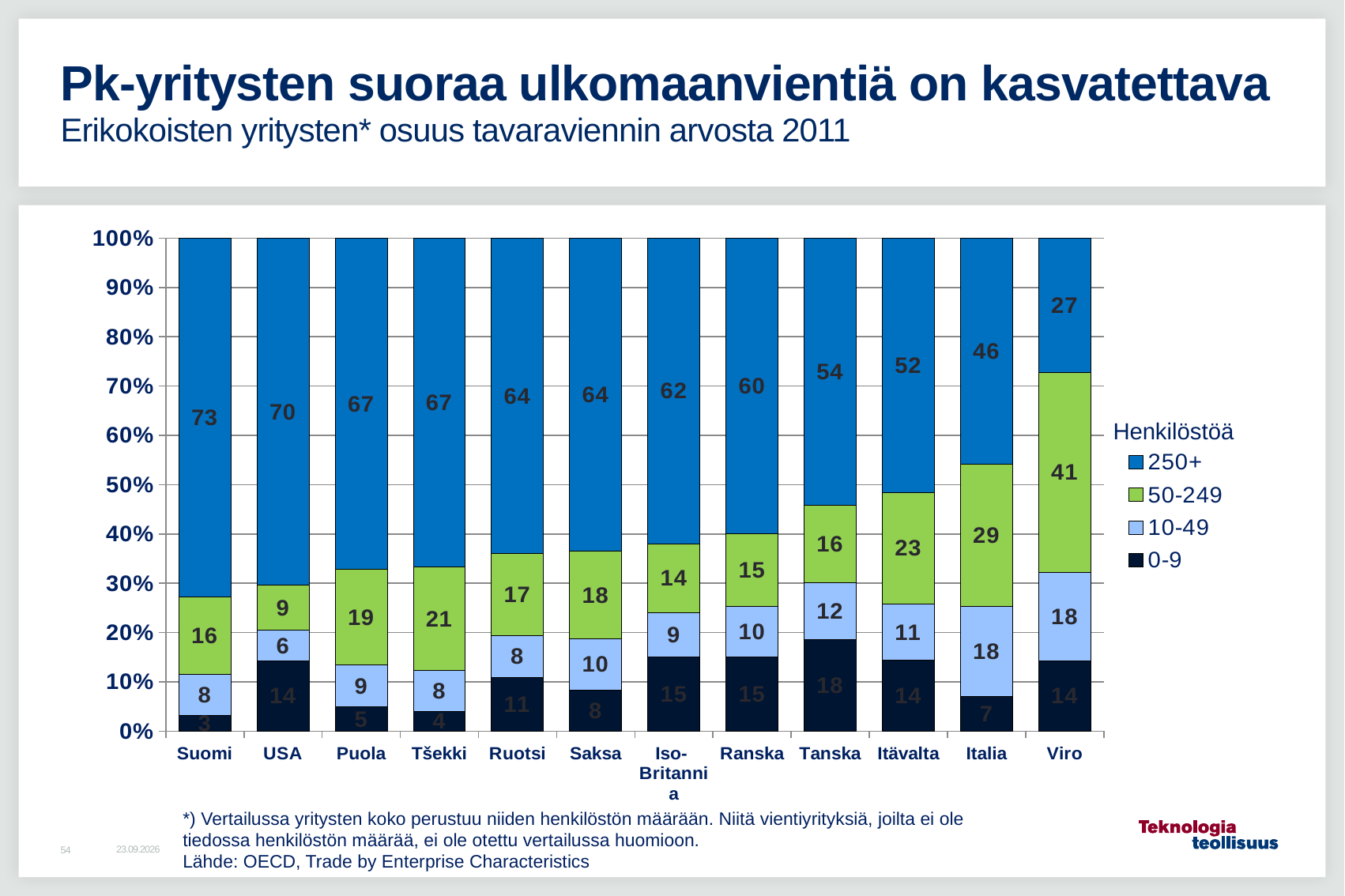
How many series does the legend list? 4 What is the difference between the 250+ values for Suomi and Viro? 46 How many countries are shown on the x axis? 12 Which is larger, the 50-249 value for Italia or for Itävalta? Italia Which country has the highest value in the 250+ series? Suomi What is the value of the 0-9 series for Tanska? 18 What is the value of the 250+ series for Suomi? 73 What is the value of the 10-49 series for Italia? 18 What is the value of the 50-249 series for Viro? 41 Do the values of the 250+ series rise or fall from Suomi to Viro along the x axis? Fall Which country has the lowest value in the 250+ series? Viro What kind of chart is shown on the slide? Stacked bar chart